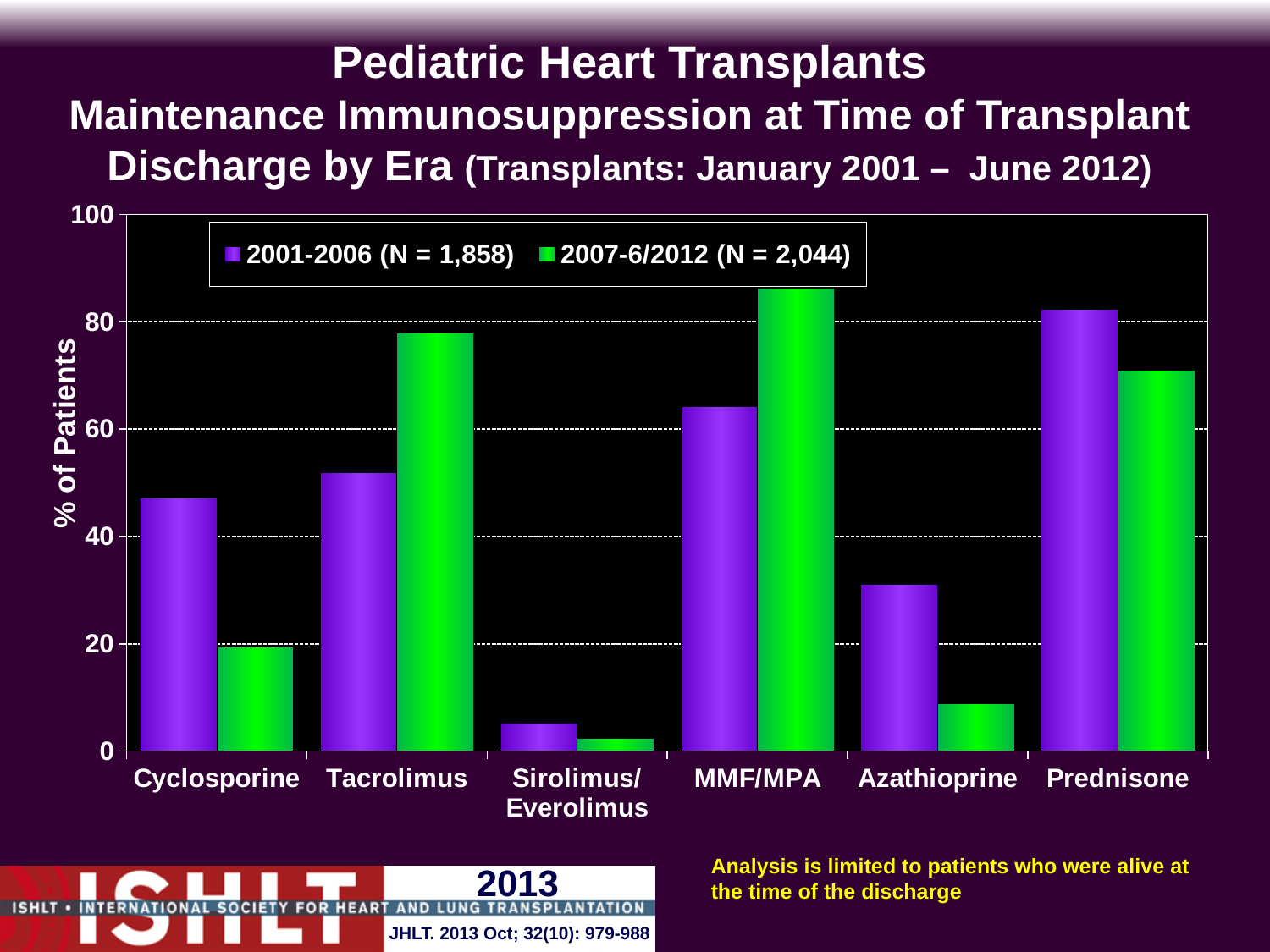
What kind of chart is shown on the slide? bar chart For Prednisone, which era has the larger value, 2001-2006 or 2007-6/2012? 2001-2006 Which category has the highest value for the 2007-6/2012 (N = 2,044) series? MMF/MPA Which category has the highest value for the 2001-2006 (N = 1,858) series? Prednisone What is the label on the y axis? % of Patients For Tacrolimus, which era has the larger value, 2001-2006 or 2007-6/2012? 2007-6/2012 Is the value for MMF/MPA in the 2007-6/2012 era greater or less than 80? greater Is the value for Azathioprine in the 2001-2006 era greater or less than 20? greater Which category has the lowest value for the 2007-6/2012 (N = 2,044) series? Sirolimus/Everolimus How many drug categories are shown on the x axis? 6 How many series does the legend list? 2